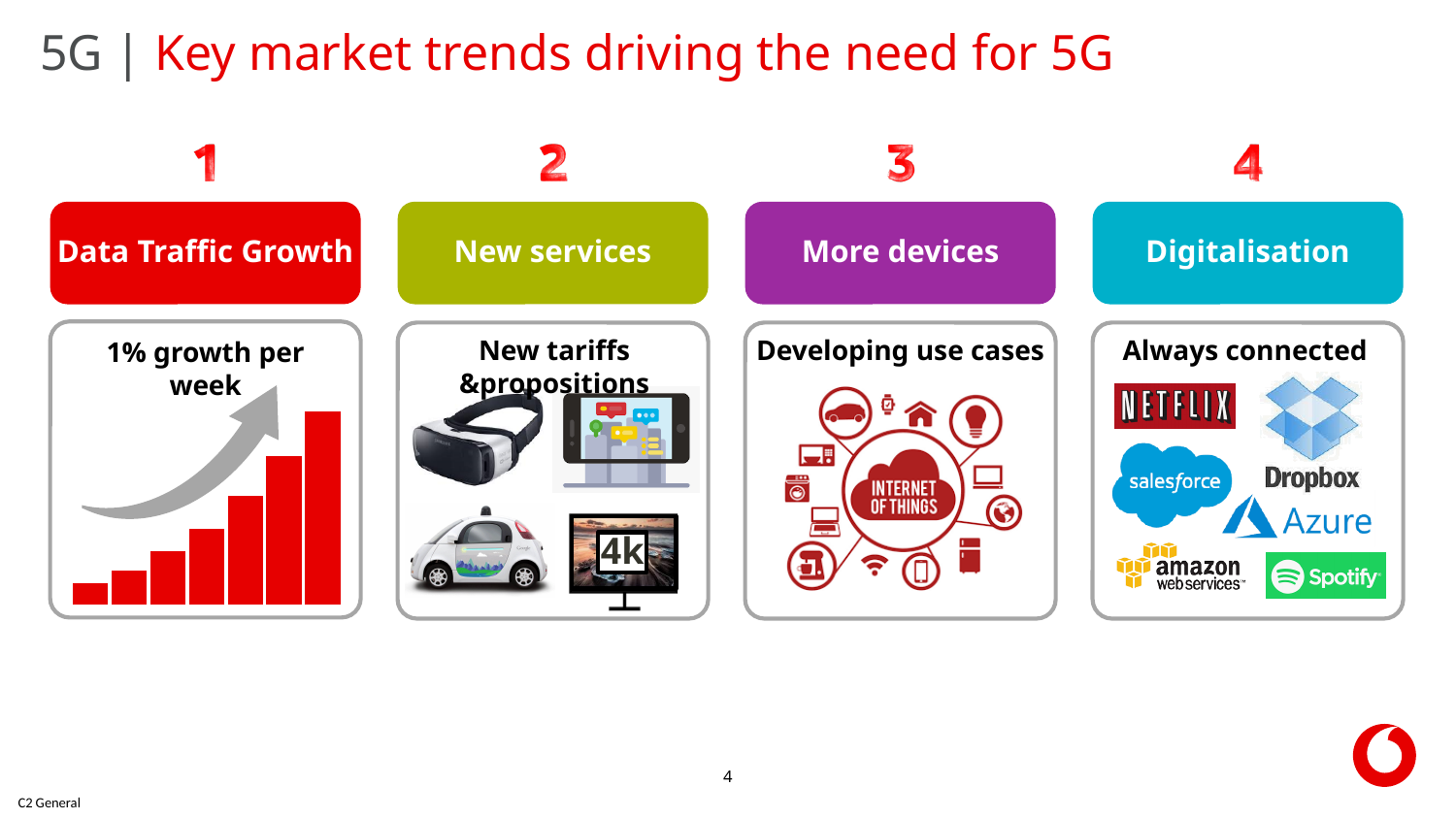
In the Data Traffic Growth bar chart, which bar is the tallest? the rightmost bar In the Data Traffic Growth bar chart, do the bars rise or fall from left to right? rise What colour are the bars in the Data Traffic Growth bar chart? red In the Data Traffic Growth bar chart, is the leftmost bar or the rightmost bar taller? the rightmost bar What growth rate is stated above the Data Traffic Growth bar chart? 1% growth per week In the Data Traffic Growth bar chart, which bar is the shortest? the leftmost bar How many bars are in the Data Traffic Growth bar chart? 7 What kind of chart is shown in the Data Traffic Growth box? bar chart